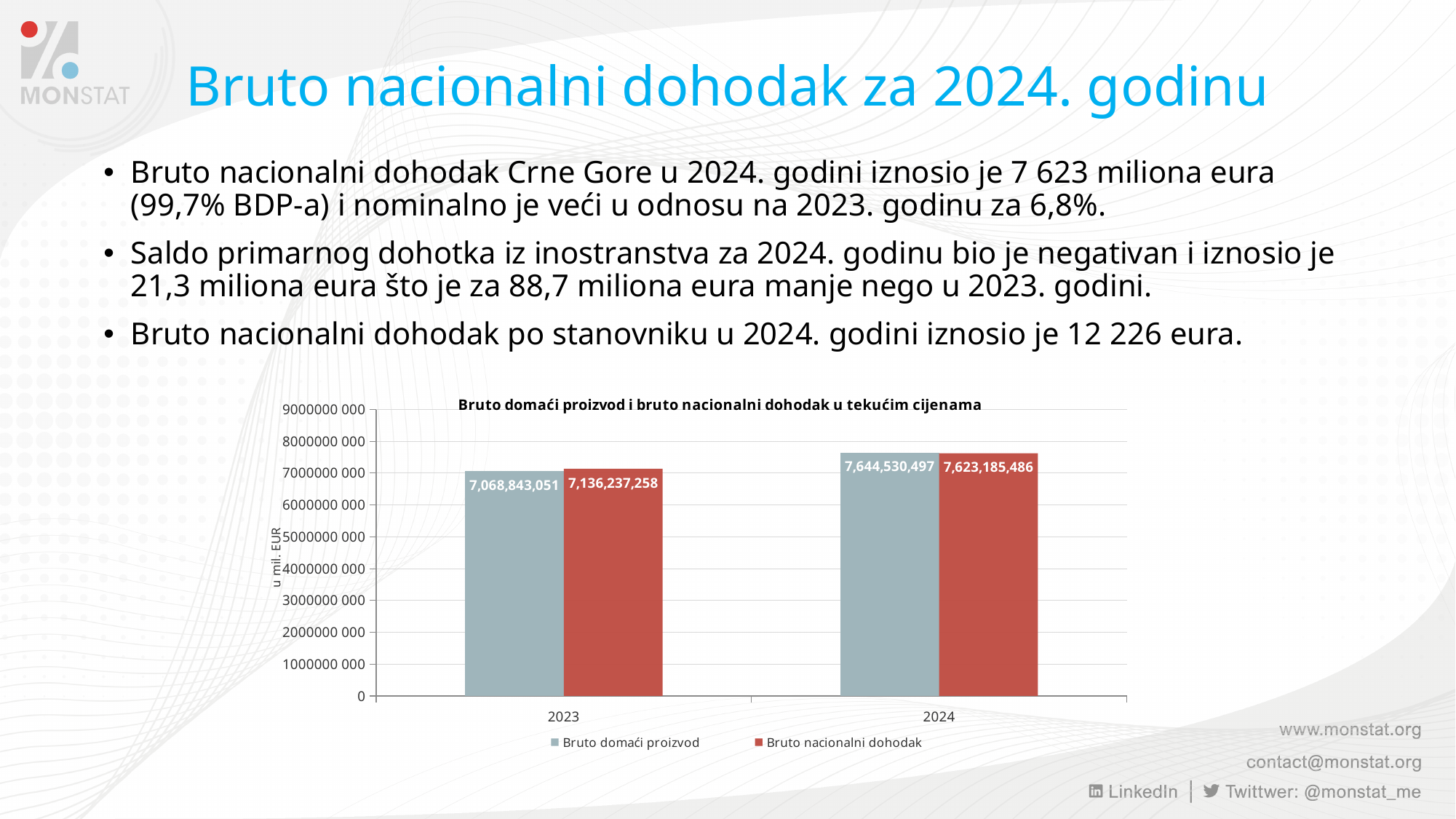
What is the difference between Bruto domaći proizvod and Bruto nacionalni dohodak in 2024? 21,345,011 What is the difference between Bruto domaći proizvod in 2024 and in 2023? 575,687,446 Which bar shows the lowest value in the chart? Bruto domaći proizvod, 2023 What is the value of Bruto nacionalni dohodak for 2024? 7,623,185,486 How many series does the legend list? 2 Which year has the higher value for Bruto domaći proizvod? 2024 Is the value for Bruto domaći proizvod in 2024 greater or less than 7000000 000? greater What is the value of Bruto nacionalni dohodak for 2023? 7,136,237,258 What is the value of Bruto domaći proizvod for 2024? 7,644,530,497 What type of chart is shown on the slide? Bar chart In 2023, which is larger: Bruto domaći proizvod or Bruto nacionalni dohodak? Bruto nacionalni dohodak What is the value of Bruto domaći proizvod for 2023? 7,068,843,051